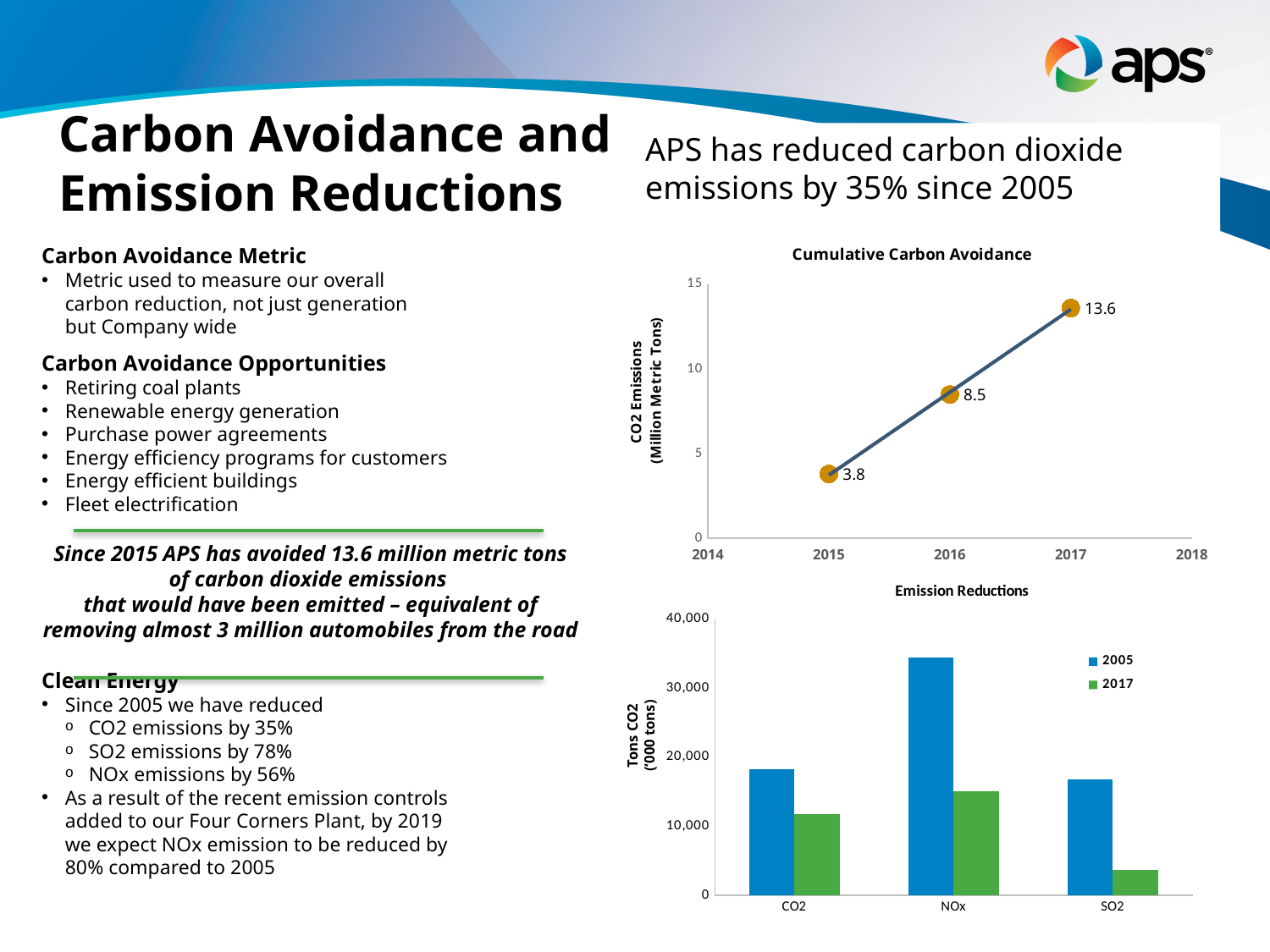
In the Cumulative Carbon Avoidance chart, how many data points are plotted? 3 In the Emission Reductions chart, which category has the lowest 2017 value? SO2 In the Emission Reductions chart, is the 2017 value for SO2 greater or less than 10,000? less In the Emission Reductions chart, which category has the highest 2005 value? NOx In the Emission Reductions chart, is the 2005 value for NOx greater or less than 30,000? greater In the Cumulative Carbon Avoidance chart, do the values rise or fall from 2015 to 2017? rise In the Cumulative Carbon Avoidance chart, what is the value for 2017? 13.6 In the Cumulative Carbon Avoidance chart, what is the difference between the 2017 and 2015 values? 9.8 In the Emission Reductions chart, which series has the larger value for CO2, 2005 or 2017? 2005 What kind of chart is the Emission Reductions chart? bar chart In the Emission Reductions chart, how many series does the legend list? 2 In the Cumulative Carbon Avoidance chart, what is the value for 2015? 3.8